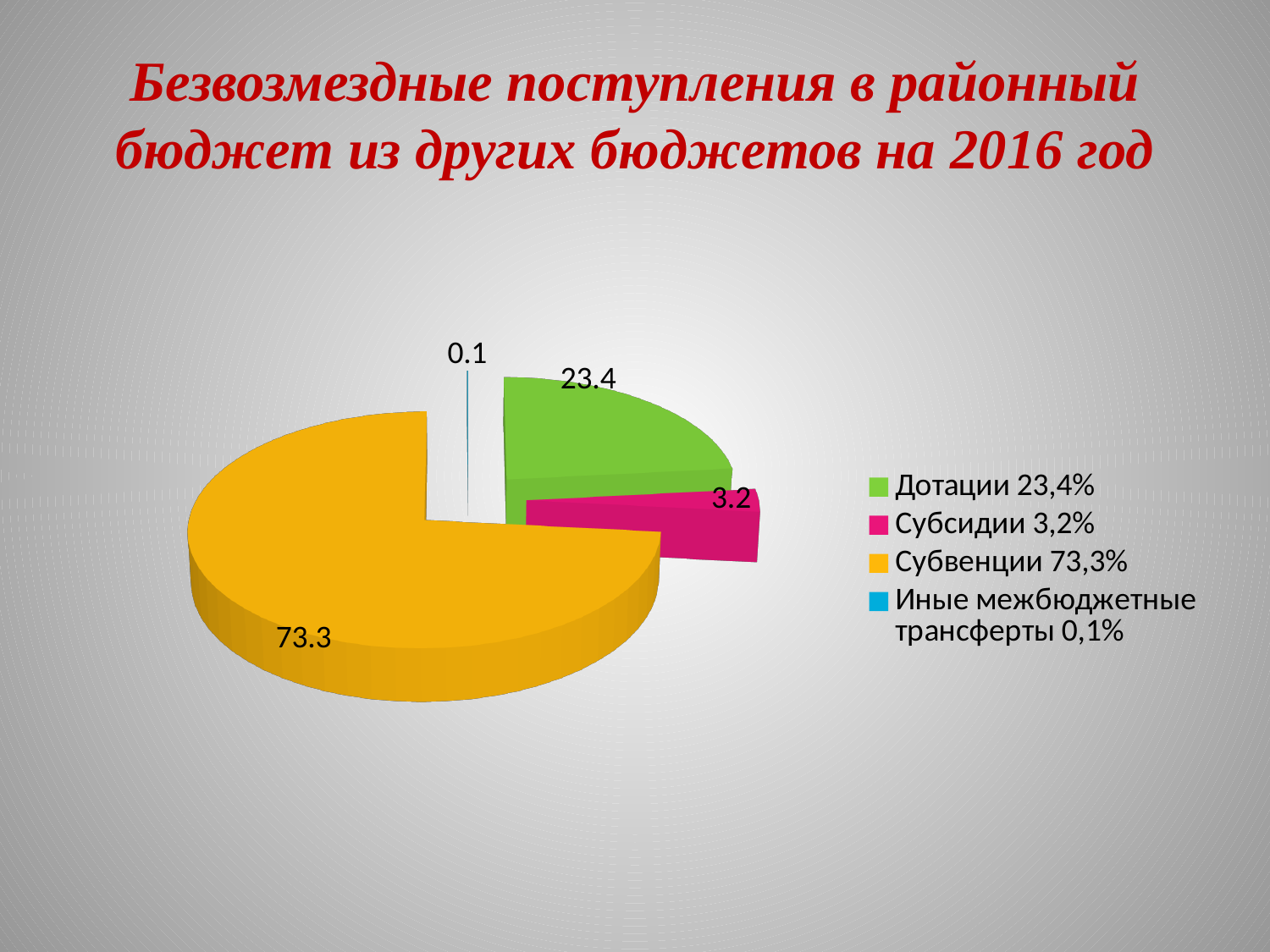
Which is larger, the Дотации slice or the Субсидии slice? Дотации Which category has the largest slice of the pie? Субвенции What colour is the Субвенции slice? yellow How many slices does the pie chart have? 4 What is the data label value for the Субсидии slice? 3.2 What is the data label value for the Иные межбюджетные трансферты slice? 0.1 Which category has the smallest slice of the pie? Иные межбюджетные трансферты What is the difference between the Субвенции value and the Дотации value? 49.9 What percentage does the legend show for Субсидии? 3,2% What kind of chart is shown on the slide? pie chart What is the data label value for the Субвенции slice? 73.3 What is the data label value for the Дотации slice? 23.4